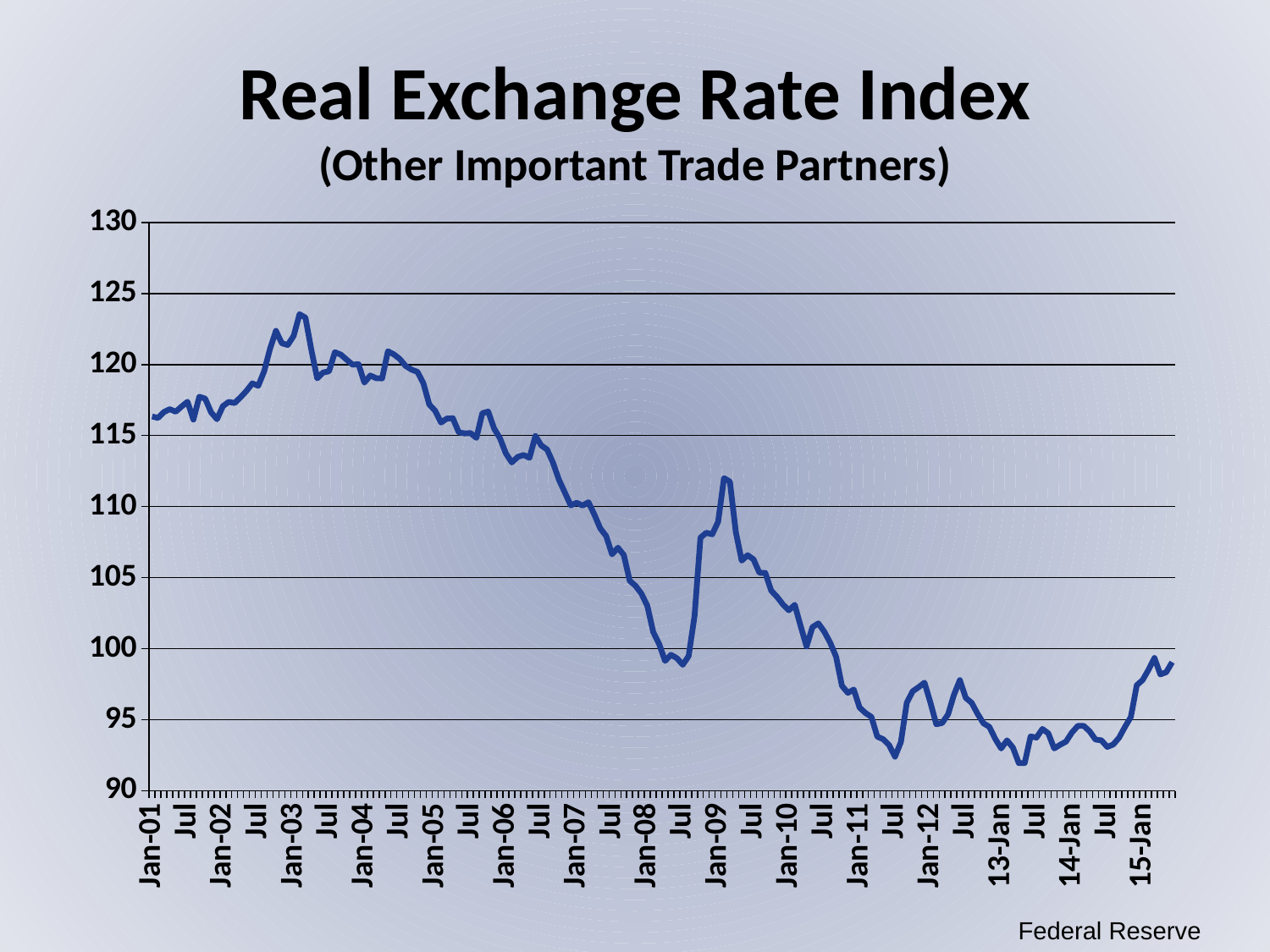
Does the index rise or fall overall from Jan-01 to 15-Jan? fall Does the index rise or fall between Jan-03 and Jan-08? fall What is the title of the chart? Real Exchange Rate Index (Other Important Trade Partners) Is the value for Jan-01 greater or less than 110? greater What kind of chart is shown on the slide? line chart Is the value for Jan-12 greater or less than 100? less Is the value for Jul-08 greater or less than 100? less In which year does the line reach its highest point? 2003 What source is cited for the chart? Federal Reserve